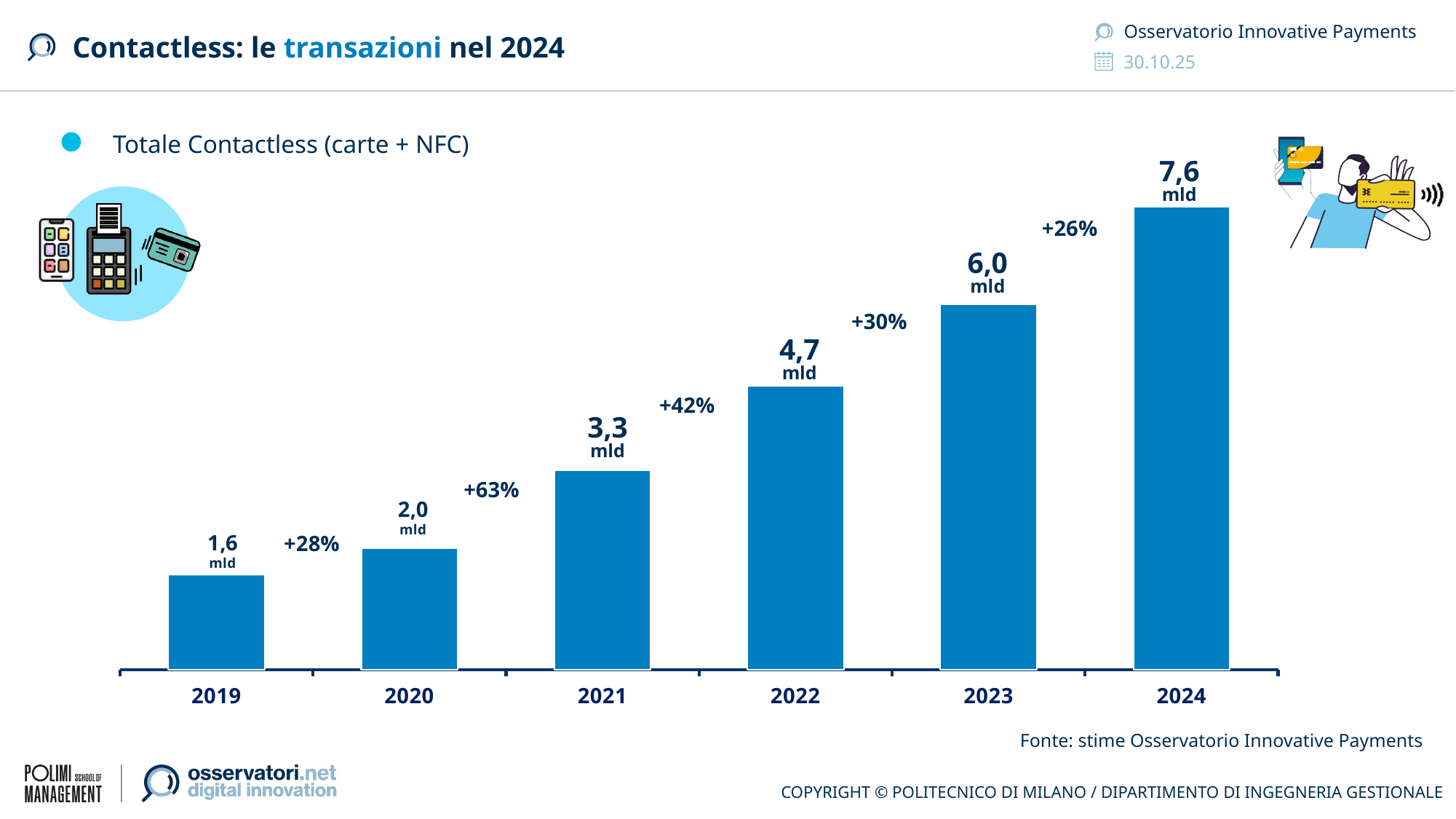
What percentage growth is shown between 2020 and 2021? +63% What percentage growth is shown between 2023 and 2024? +26% What is the value for 2024? 7,6 mld Which is larger, the value for 2021 or the value for 2022? 2022 Which year has the highest value? 2024 Which year has the lowest value? 2019 What kind of chart is this? Bar chart What is the value for 2022? 4,7 mld What is the difference between the 2024 value and the 2023 value? 1,6 mld What is the value for 2019? 1,6 mld How many years are shown on the x axis? 6 Do the values rise or fall from 2019 to 2024? Rise